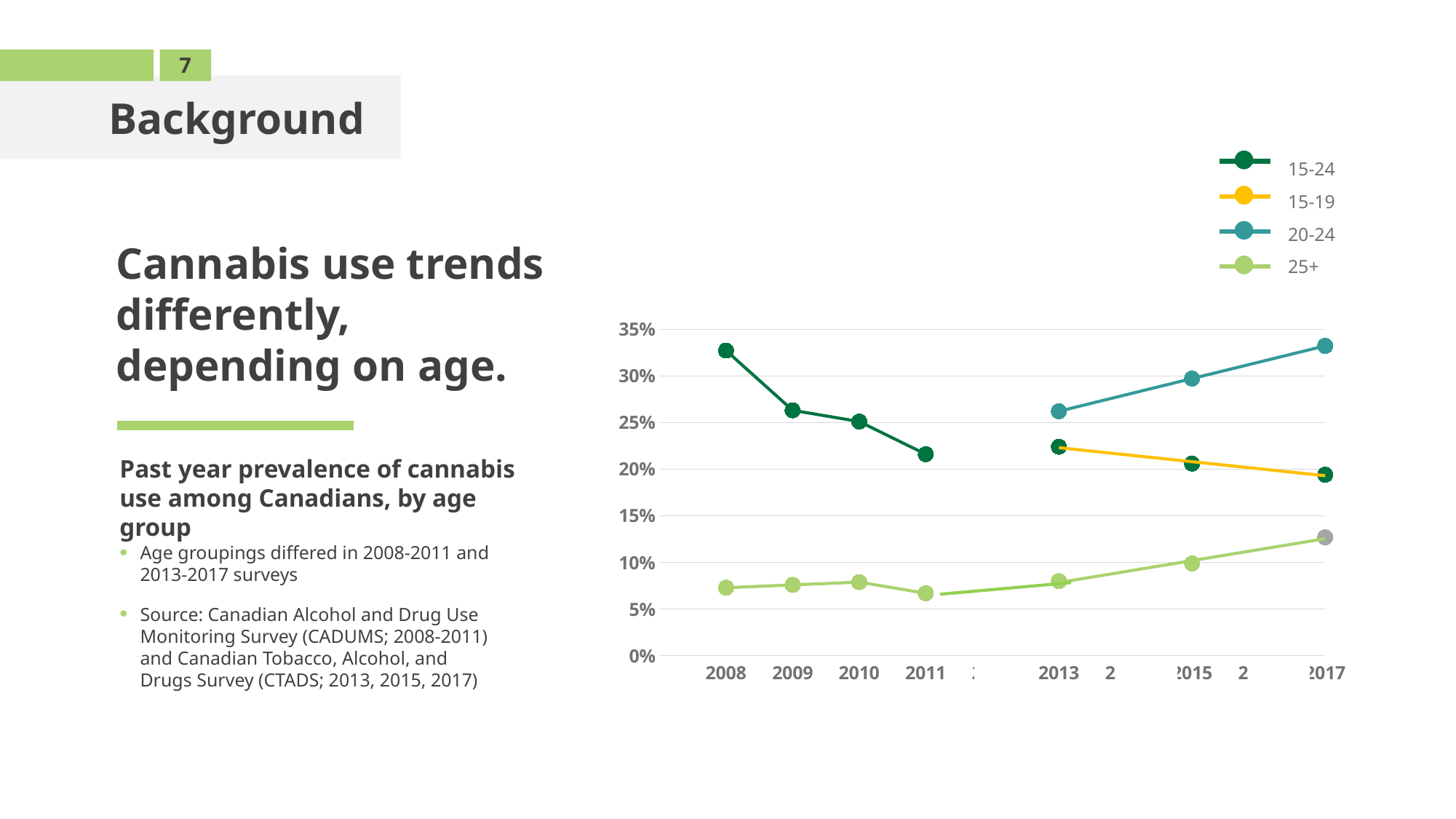
Is the value for the 15-24 group in 2008 greater or less than 30%? greater Is the value for the 15-19 group in 2017 greater or less than 20%? less Does the 15-24 series rise or fall from 2008 to 2011? fall Does the 20-24 series rise or fall from 2013 to 2017? rise Is the value for the 20-24 group in 2013 greater or less than 25%? greater How many series does the legend list? 4 How many data points are plotted for the 20-24 series? 3 Which age groups are listed in the legend? 15-24, 15-19, 20-24, 25+ How many data points are plotted for the 15-24 series? 4 What kind of chart is shown on the slide? line chart In 2017, which age group has the highest value? 20-24